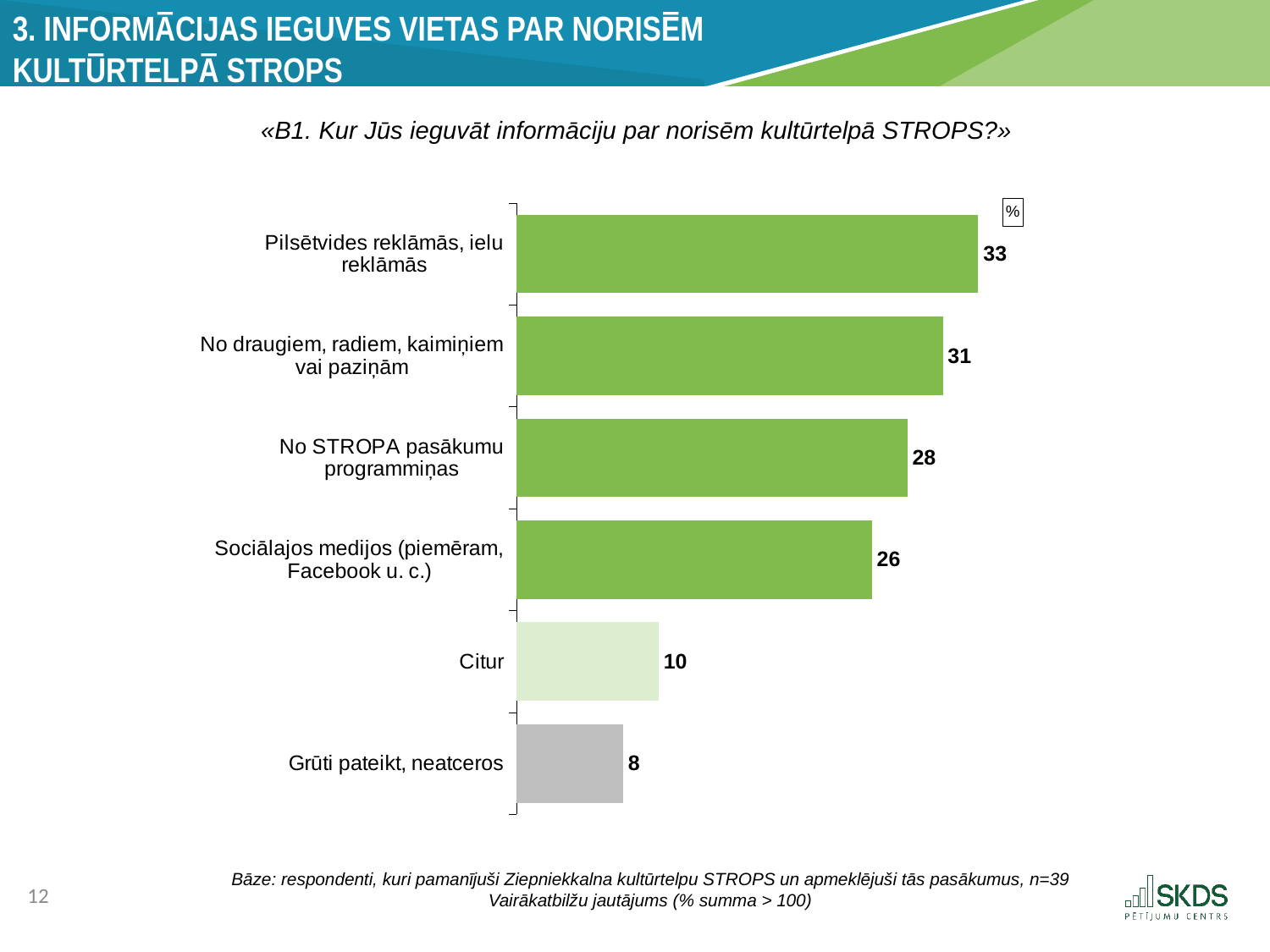
What is the value for "Pilsētvides reklāmās, ielu reklāmās"? 33 What is the difference between the values for "Sociālajos medijos (piemēram, Facebook u. c.)" and "Citur"? 16 What is the value for "Citur"? 10 How many categories are shown in the chart? 6 What is the value for "No STROPA pasākumu programmiņas"? 28 What is the difference between the values for "Pilsētvides reklāmās, ielu reklāmās" and "No draugiem, radiem, kaimiņiem vai paziņām"? 2 What is the base size (n) stated below the chart? n=39 Which category has the lowest value? Grūti pateikt, neatceros Which is larger: the value for "No STROPA pasākumu programmiņas" or the value for "Sociālajos medijos (piemēram, Facebook u. c.)"? No STROPA pasākumu programmiņas What is the value for "Sociālajos medijos (piemēram, Facebook u. c.)"? 26 What kind of chart is shown on the slide? Bar chart Which category has the highest value? Pilsētvides reklāmās, ielu reklāmās